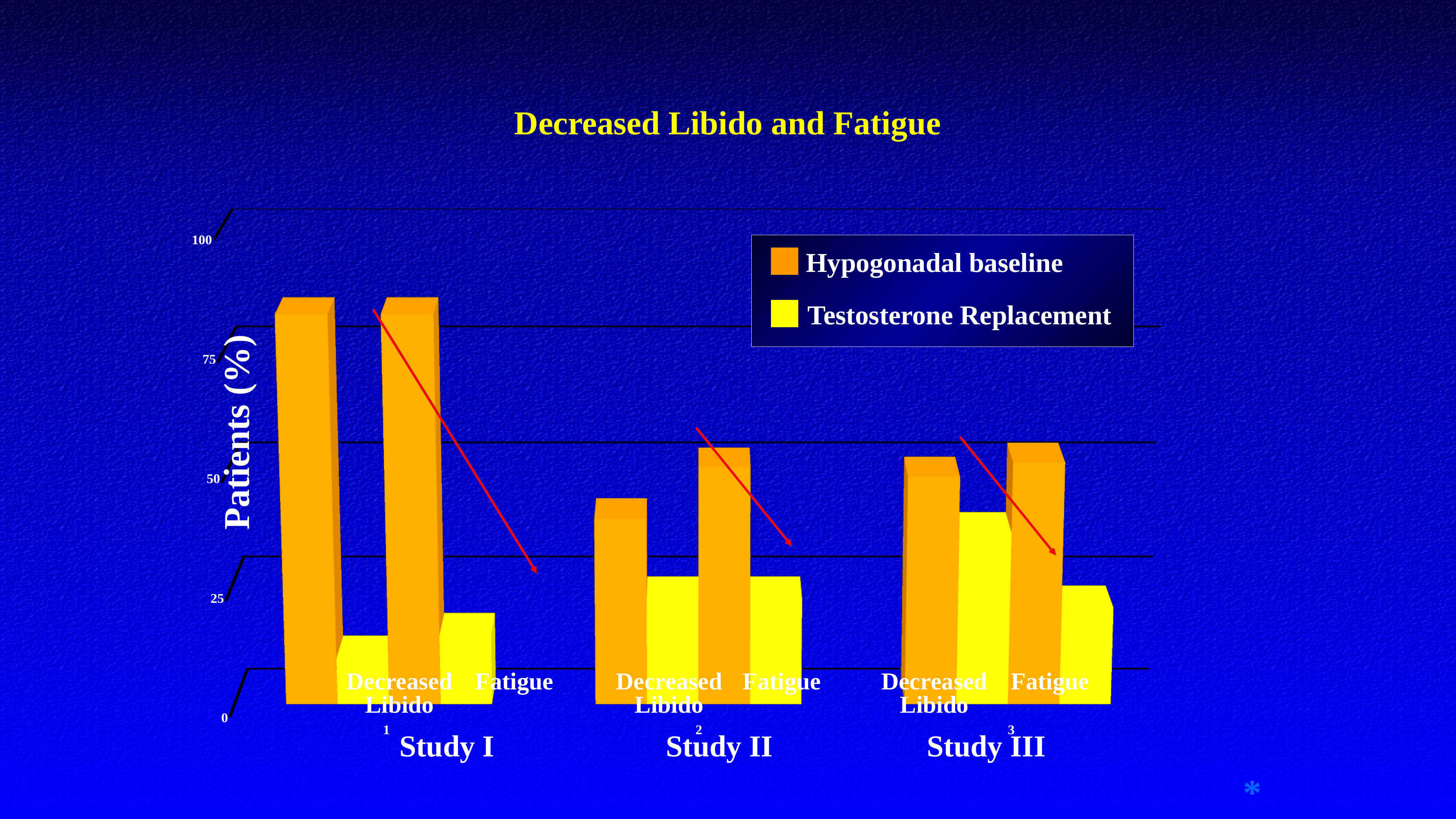
Is the Testosterone Replacement value for Decreased Libido in Study I greater or less than 25? less How many studies are shown along the x axis? 3 Within each study, do the values fall or rise from Hypogonadal baseline to Testosterone Replacement? fall Among the Testosterone Replacement bars, which study and symptom has the highest value? Study III, Decreased Libido What kind of chart is shown on the slide? bar chart Is the Hypogonadal baseline value for Decreased Libido in Study II greater or less than 50? less How many series does the legend list? 2 Which series is shown in yellow in the legend? Testosterone Replacement What is the title of the chart? Decreased Libido and Fatigue Is the Hypogonadal baseline value for Decreased Libido in Study I greater or less than 75? greater Which is larger: the Hypogonadal baseline value for Decreased Libido in Study I or in Study II? Study I